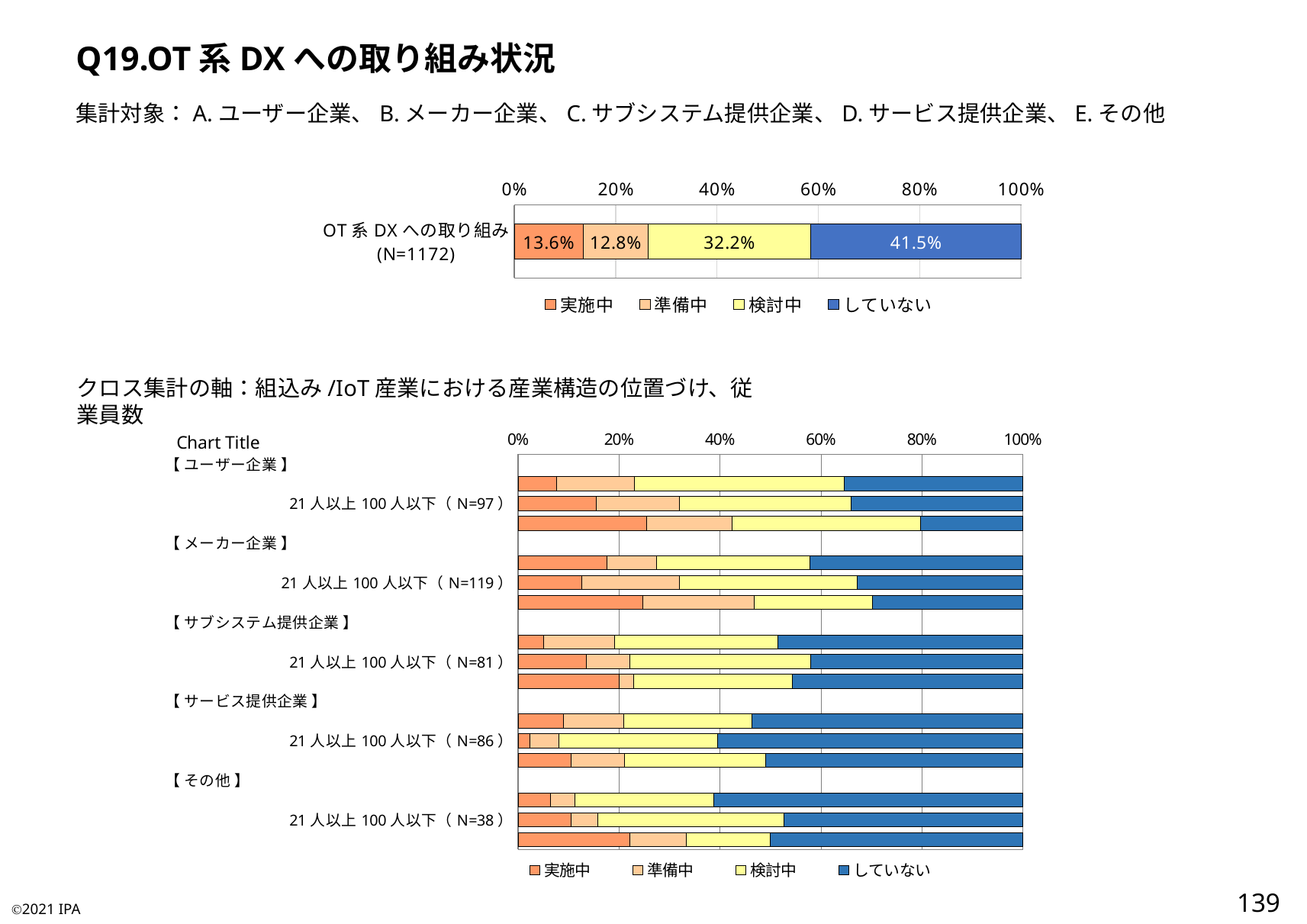
In the top chart (OT系DXへの取り組み, N=1172), what is the value for していない? 41.5% In the bottom chart, what are the four legend entries? 実施中, 準備中, 検討中, していない What kind of chart is the top chart (OT系DXへの取り組み, N=1172)? Stacked bar chart In the top chart (OT系DXへの取り組み, N=1172), what is the value for 検討中? 32.2% In the top chart (OT系DXへの取り組み, N=1172), which is larger, 実施中 or 準備中? 実施中 How many series does the legend of the top chart list? 4 In the top chart (OT系DXへの取り組み, N=1172), which category has the smallest share? 準備中 In the bottom chart, is the していない share for the ユーザー企業 row 21人以上100人以下 (N=97) greater or less than 20%? greater In the top chart (OT系DXへの取り組み, N=1172), which category has the largest share? していない In the bottom chart, is the 実施中 share for the サービス提供企業 row 21人以上100人以下 (N=86) greater or less than 20%? less In the top chart (OT系DXへの取り組み, N=1172), what is the difference between 検討中 and 実施中? 18.6% In the top chart (OT系DXへの取り組み, N=1172), what is the value for 実施中? 13.6%